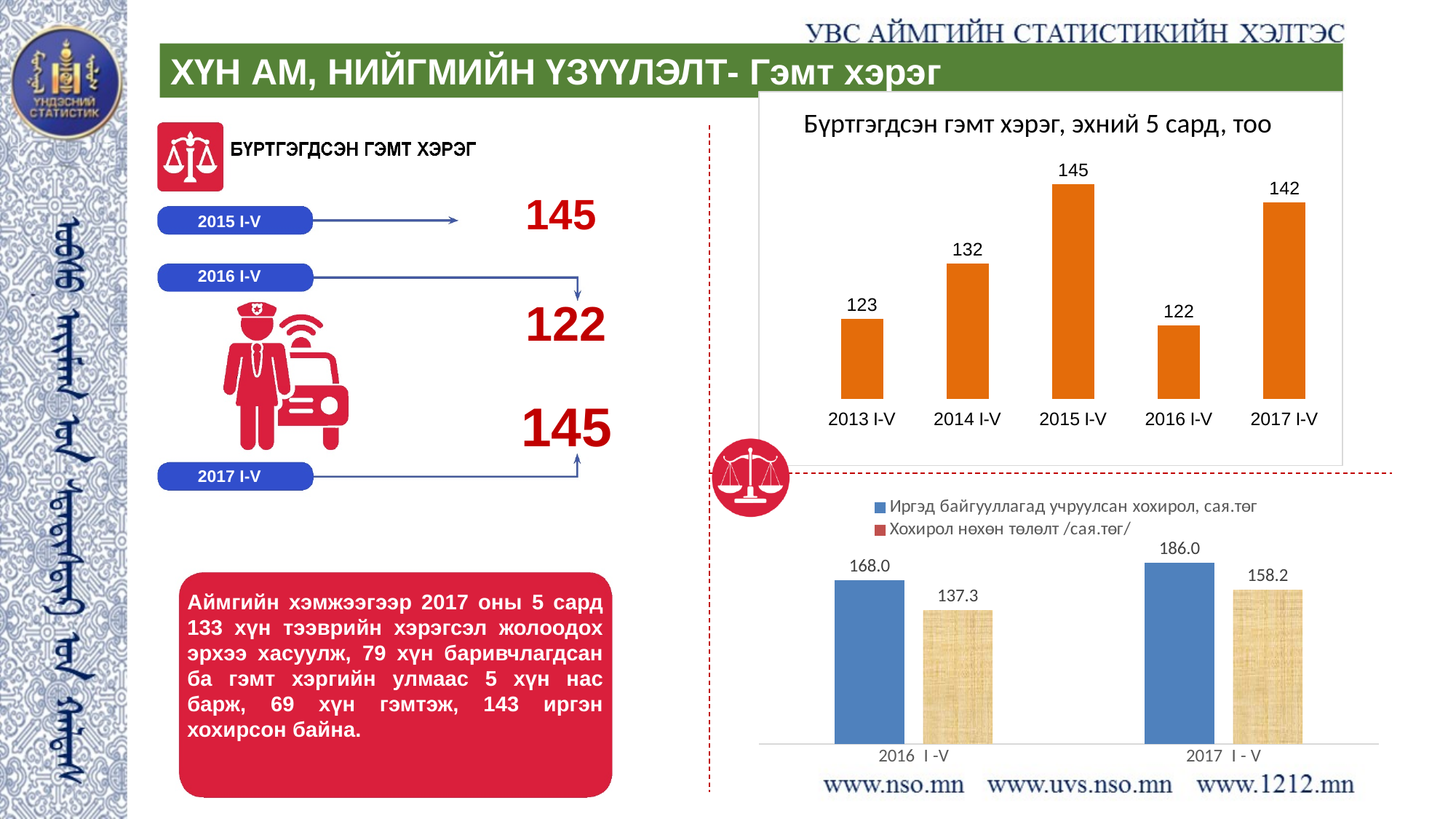
In the bottom chart, is 'Хохирол нөхөн төлөлт /сая.төг/' larger in 2016 I-V or 2017 I-V? 2017 I-V What type of chart is the top chart 'Бүртгэгдсэн гэмт хэрэг, эхний 5 сард, тоо'? Bar chart In the bottom chart, what is the value of 'Хохирол нөхөн төлөлт /сая.төг/' for 2016 I-V? 137.3 In the top chart 'Бүртгэгдсэн гэмт хэрэг, эхний 5 сард, тоо', what is the value for 2017 I-V? 142 In the top chart 'Бүртгэгдсэн гэмт хэрэг, эхний 5 сард, тоо', which period has the highest value? 2015 I-V In the top chart 'Бүртгэгдсэн гэмт хэрэг, эхний 5 сард, тоо', what is the difference between the values for 2015 I-V and 2016 I-V? 23 In the bottom chart, how many series does the legend list? 2 In the top chart 'Бүртгэгдсэн гэмт хэрэг, эхний 5 сард, тоо', which period has the lowest value? 2016 I-V In the bottom chart, what is the value of 'Иргэд байгууллагад учруулсан хохирол, сая.төг' for 2017 I-V? 186.0 In the top chart 'Бүртгэгдсэн гэмт хэрэг, эхний 5 сард, тоо', how many periods are shown? 5 In the top chart 'Бүртгэгдсэн гэмт хэрэг, эхний 5 сард, тоо', what is the value for 2014 I-V? 132 In the bottom chart, what is the difference between 'Иргэд байгууллагад учруулсан хохирол, сая.төг' and 'Хохирол нөхөн төлөлт /сая.төг/' for 2017 I-V? 27.8